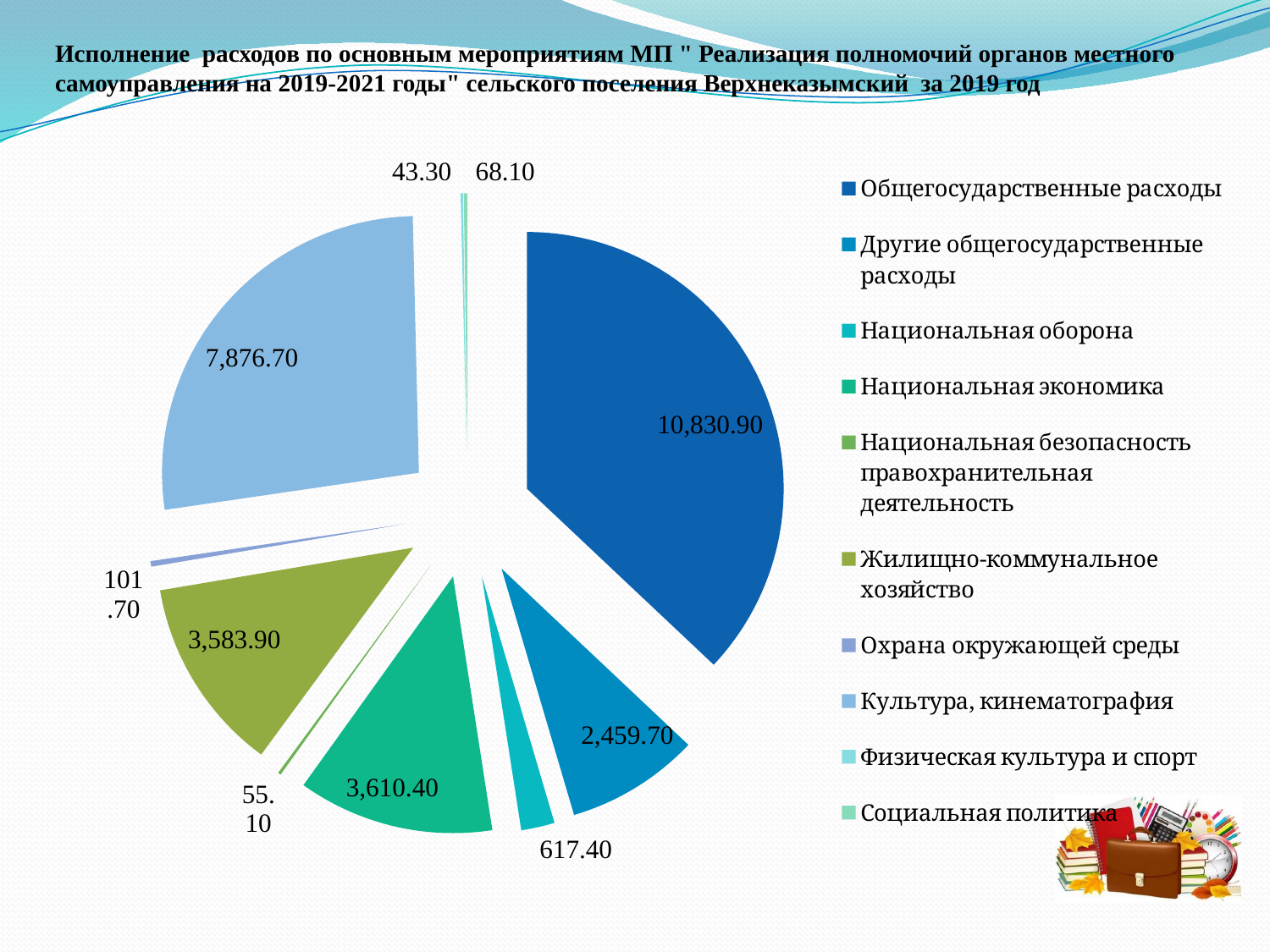
What is the value for Культура, кинематография? 7,876.70 Which is larger, the value for Национальная экономика or the value for Жилищно-коммунальное хозяйство? Национальная экономика What is the difference between the values for Общегосударственные расходы and Культура, кинематография? 2,954.20 What kind of chart is shown on the slide? pie chart What colour is the slice for Общегосударственные расходы? dark blue What is the value for Общегосударственные расходы? 10,830.90 What is the value for Охрана окружающей среды? 101.70 What is the value for Жилищно-коммунальное хозяйство? 3,583.90 What is the value for Национальная оборона? 617.40 Which category has the largest slice of the pie? Общегосударственные расходы Which category has the smallest value in the pie chart? Физическая культура и спорт How many categories does the legend of the pie chart list? 10